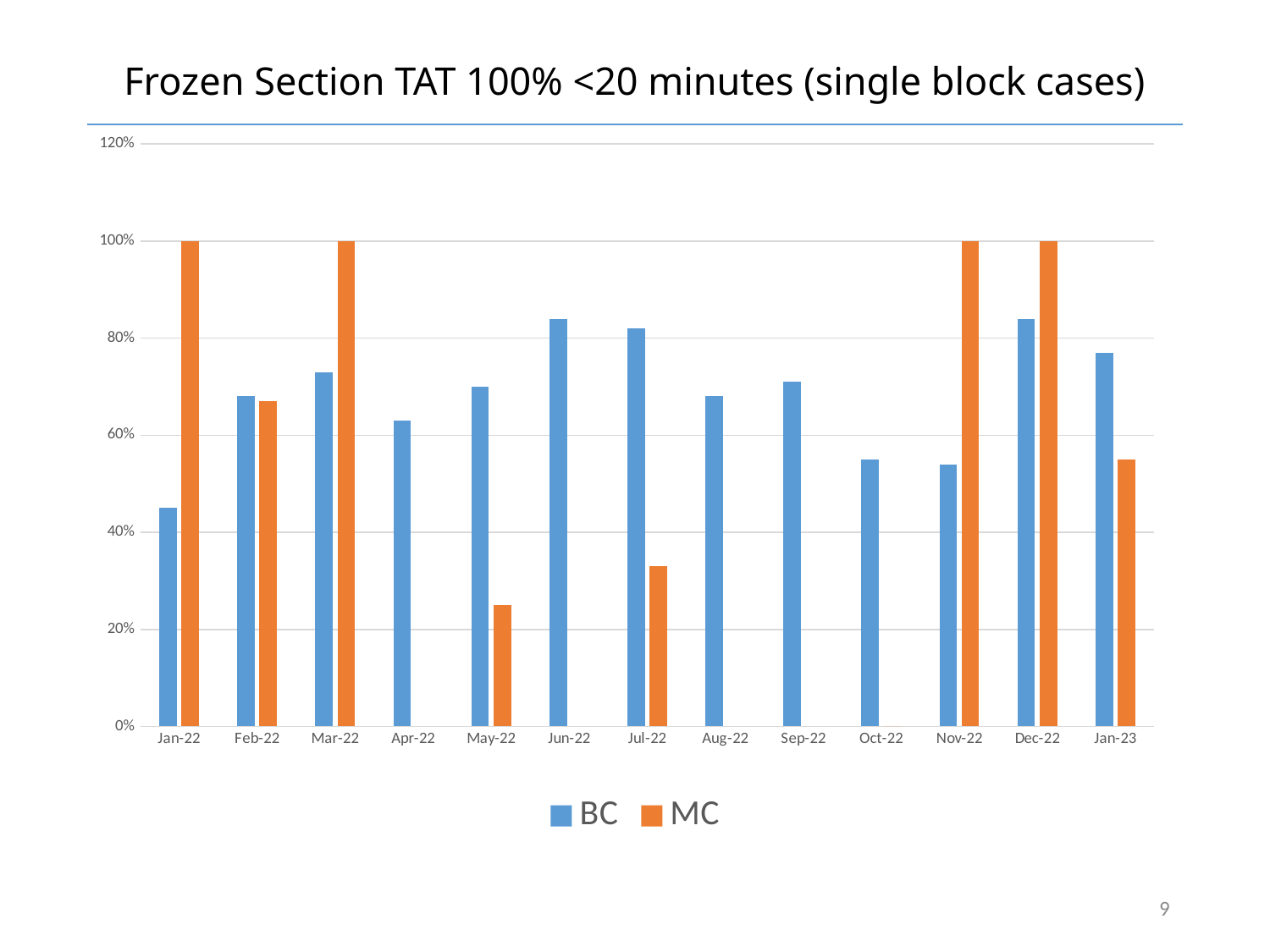
Is the BC value for Jan-22 greater or less than 60%? less In Jul-22, which series has the larger value, BC or MC? BC Is the BC value for Jun-22 greater or less than 80%? greater What kind of chart is shown on the slide? bar chart What is the title of the chart? Frozen Section TAT 100% <20 minutes (single block cases) What is the MC value for Jan-22? 100% In Jan-22, which series has the larger value, BC or MC? MC Which month has the lowest BC value? Jan-22 How many series does the legend list? 2 Is the MC value for May-22 greater or less than 40%? less What is the MC value for Nov-22? 100% How many months are shown on the x axis? 13